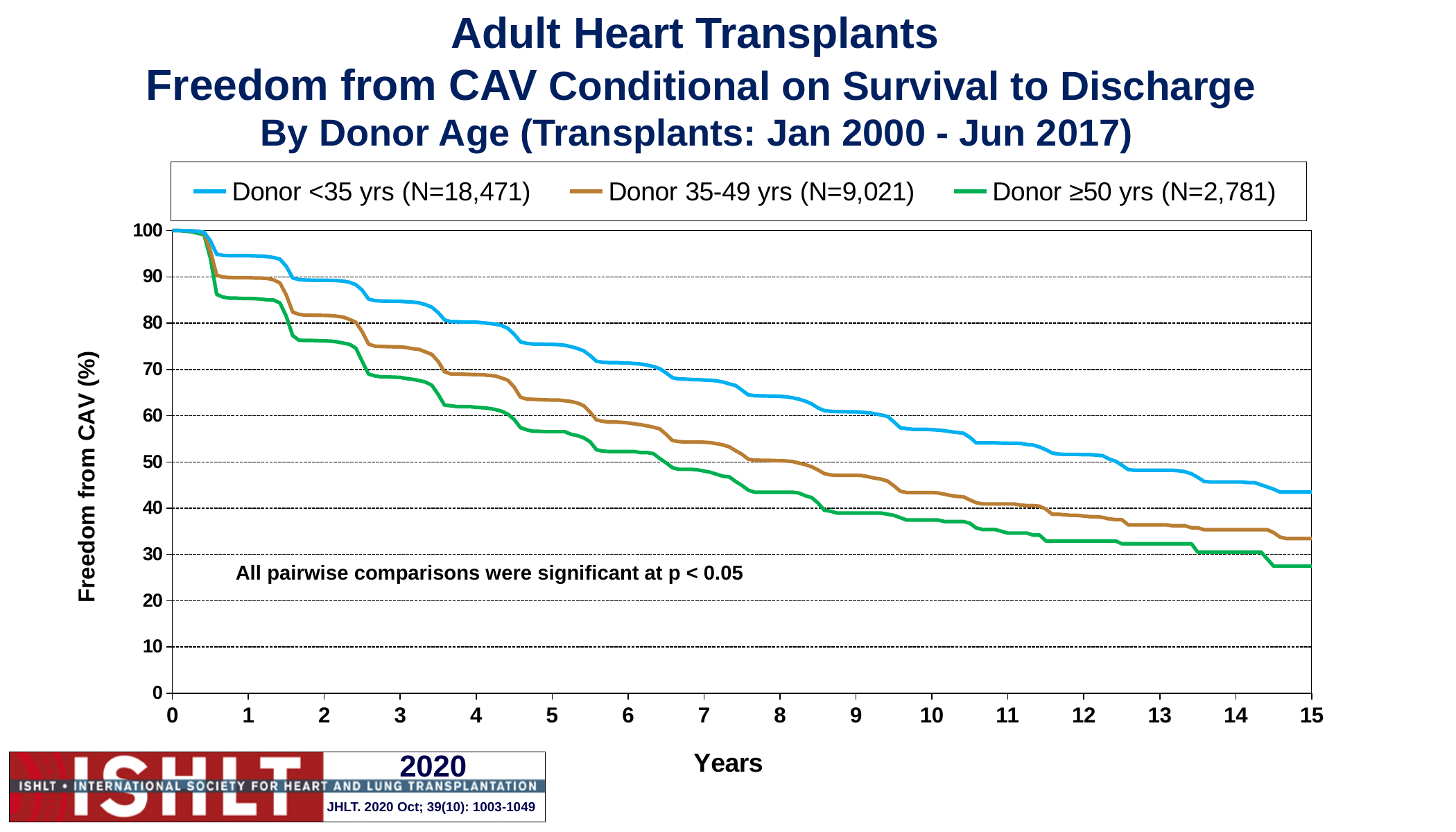
At 10 years, which is larger: freedom from CAV for Donor <35 yrs or Donor ≥50 yrs? Donor <35 yrs Which donor age group has the lowest freedom from CAV at 15 years? Donor ≥50 yrs What is the N for the Donor <35 yrs series shown in the legend? 18,471 Is the freedom from CAV for Donor <35 yrs at 15 years greater or less than 40? greater What is the N for the Donor ≥50 yrs series shown in the legend? 2,781 Is the freedom from CAV for Donor ≥50 yrs at 15 years greater or less than 30? less Is the freedom from CAV for Donor 35-49 yrs at 5 years greater or less than 60? greater How many series does the legend list? 3 Do the freedom from CAV curves rise or fall as years increase? fall What kind of chart is shown on the slide? line chart What is the label of the y axis? Freedom from CAV (%) Which donor age group has the highest freedom from CAV at 15 years? Donor <35 yrs